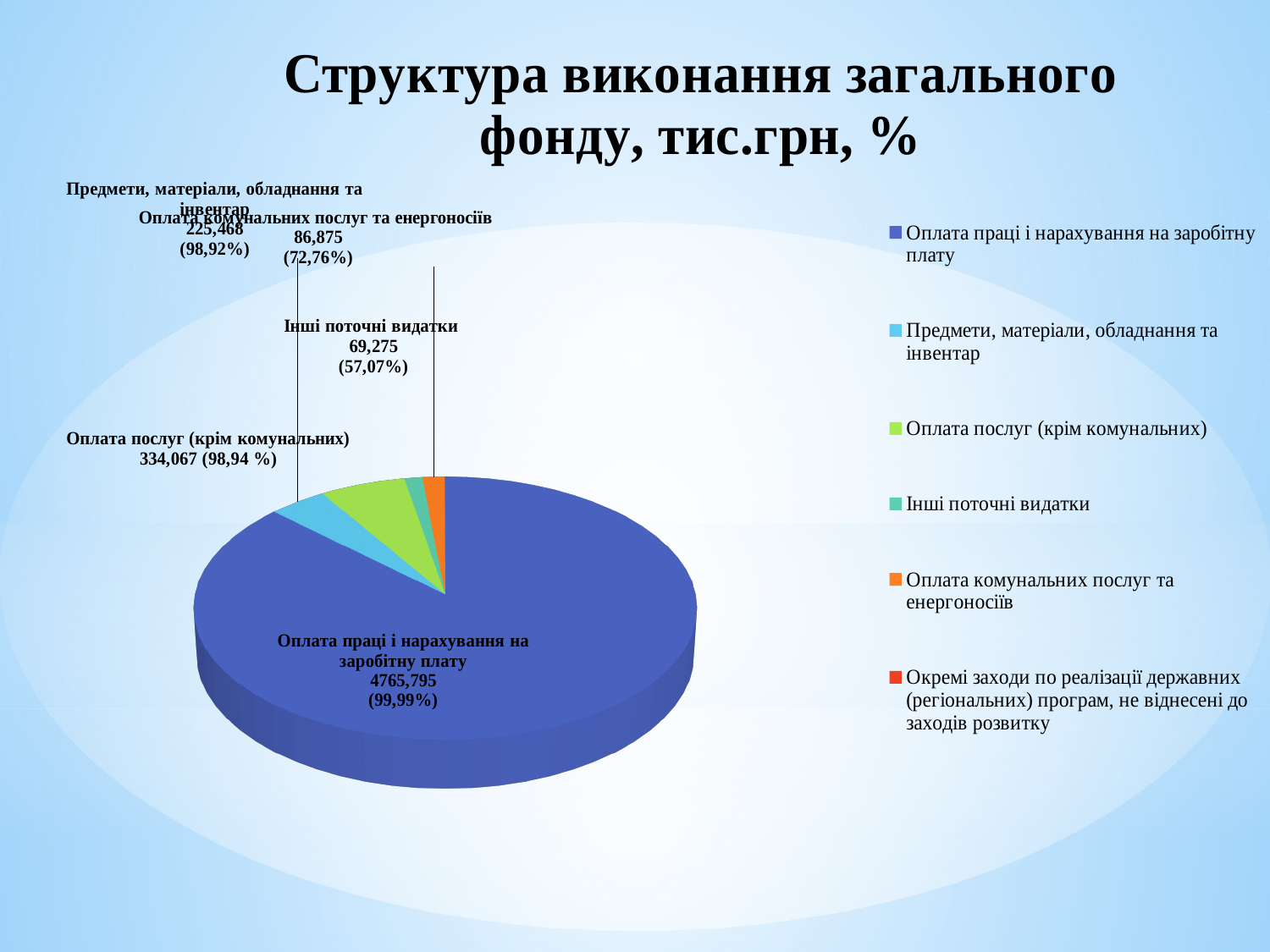
What percentage is shown in parentheses for Інші поточні видатки? 57,07% What value is labelled for Інші поточні видатки? 69,275 Which category has the largest slice of the pie? Оплата праці і нарахування на заробітну плату How many categories does the legend list? 6 What type of chart is shown on the slide? Pie chart What value is labelled for Оплата праці і нарахування на заробітну плату? 4765,795 What value is labelled for Предмети, матеріали, обладнання та інвентар? 225,468 What is the difference between the value for Оплата послуг (крім комунальних) and the value for Предмети, матеріали, обладнання та інвентар? 108,599 Which is larger, the value for Оплата послуг (крім комунальних) or the value for Предмети, матеріали, обладнання та інвентар? Оплата послуг (крім комунальних) What value is labelled for Оплата послуг (крім комунальних)? 334,067 What value is labelled for Оплата комунальних послуг та енергоносіїв? 86,875 What is the title of the chart? Структура виконання загального фонду, тис.грн, %